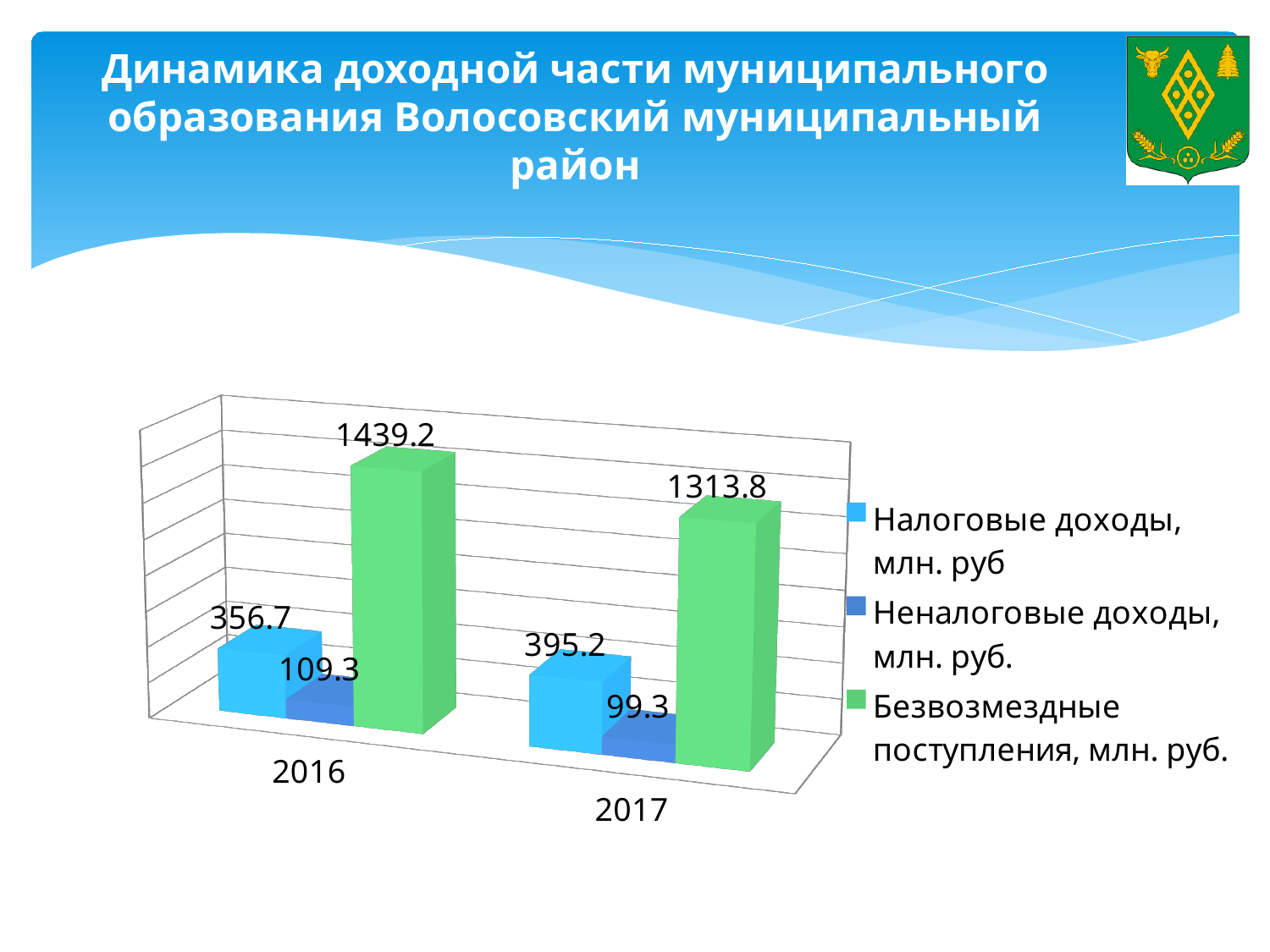
What is the value of Безвозмездные поступления, млн. руб. for 2016? 1439.2 What is the value of Налоговые доходы, млн. руб for 2016? 356.7 Which series has the lowest value in 2016? Неналоговые доходы, млн. руб. Which year has the larger value for Налоговые доходы, млн. руб: 2016 or 2017? 2017 By how much did Безвозмездные поступления, млн. руб. change from 2016 to 2017? 125.4 What kind of chart is shown on the slide? Bar chart What is the value of Безвозмездные поступления, млн. руб. for 2017? 1313.8 Which series has the highest value in 2017? Безвозмездные поступления, млн. руб. What is the value of Неналоговые доходы, млн. руб. for 2017? 99.3 What is the difference between Налоговые доходы, млн. руб in 2017 and 2016? 38.5 How many series does the legend list? 3 How many years are shown on the x axis? 2